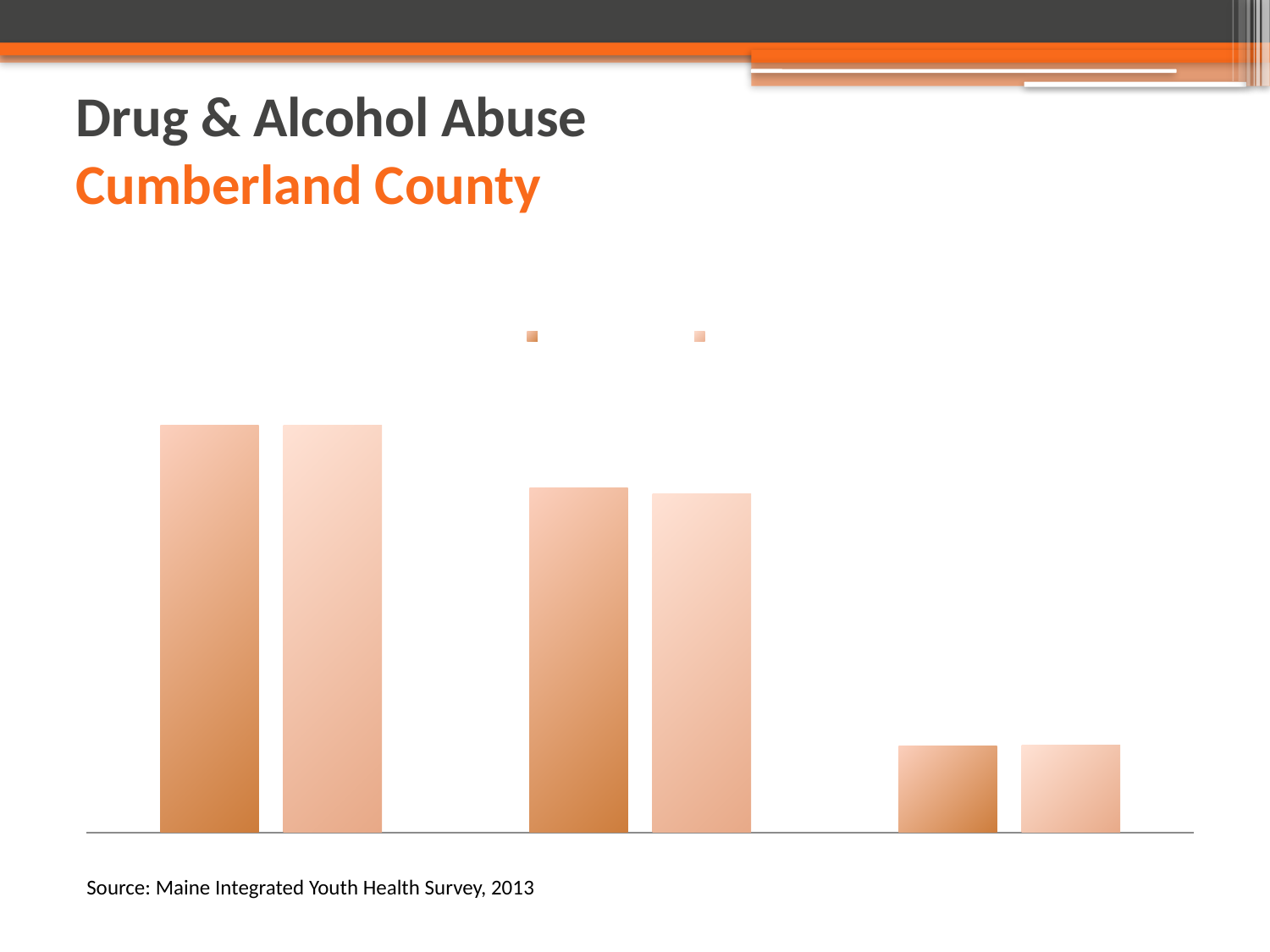
How many series does the chart's legend list? 2 Do the bar heights rise or fall moving from the left group to the right group of the chart? fall Which group of bars is the shortest: the leftmost, the middle, or the rightmost? rightmost Which group of bars is the tallest: the leftmost, the middle, or the rightmost? leftmost How many groups of bars are plotted in the chart? 3 What county is named in the slide title above the chart? Cumberland County What kind of chart is shown on the slide? bar chart What source is cited below the chart? Maine Integrated Youth Health Survey, 2013 How many bars are plotted in the chart in total? 6